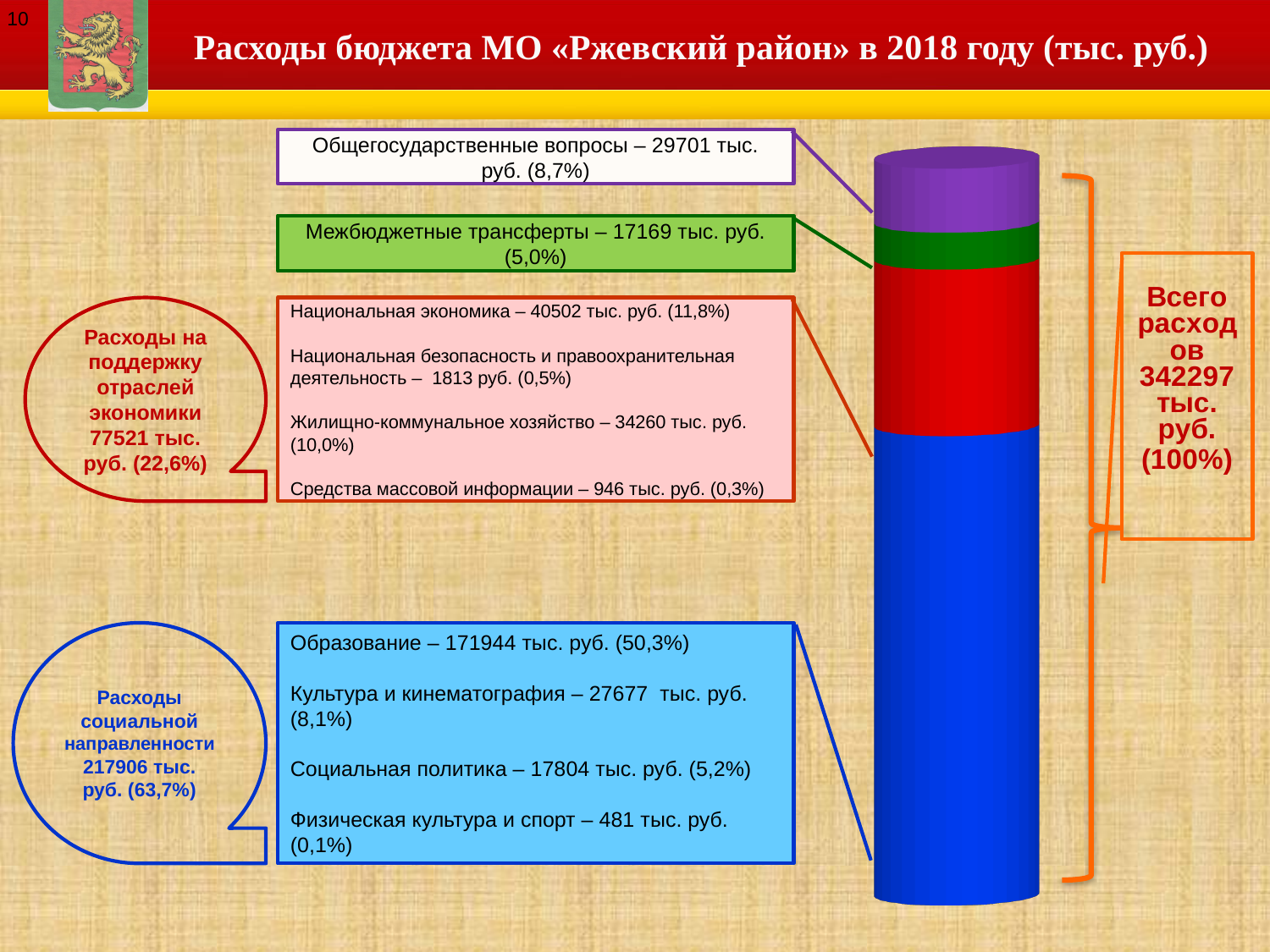
How many coloured segments make up the stacked bar? 4 What is the value for Расходы социальной направленности? 217906 тыс. руб. What is the value for Общегосударственные вопросы? 29701 тыс. руб. What is the difference between Расходы социальной направленности and Расходы на поддержку отраслей экономики? 140385 тыс. руб. Which segment of the stacked bar is the smallest? Межбюджетные трансферты What kind of chart is shown on the slide? Stacked bar chart What is the total of all budget expenditures shown in the stacked bar? 342297 тыс. руб. Which segment of the stacked bar is the largest? Расходы социальной направленности Which colour represents Расходы социальной направленности in the stacked bar? Blue What share of total expenditures is Расходы на поддержку отраслей экономики? 22,6% What is the value for Межбюджетные трансферты? 17169 тыс. руб. What share of total expenditures is Образование? 50,3%